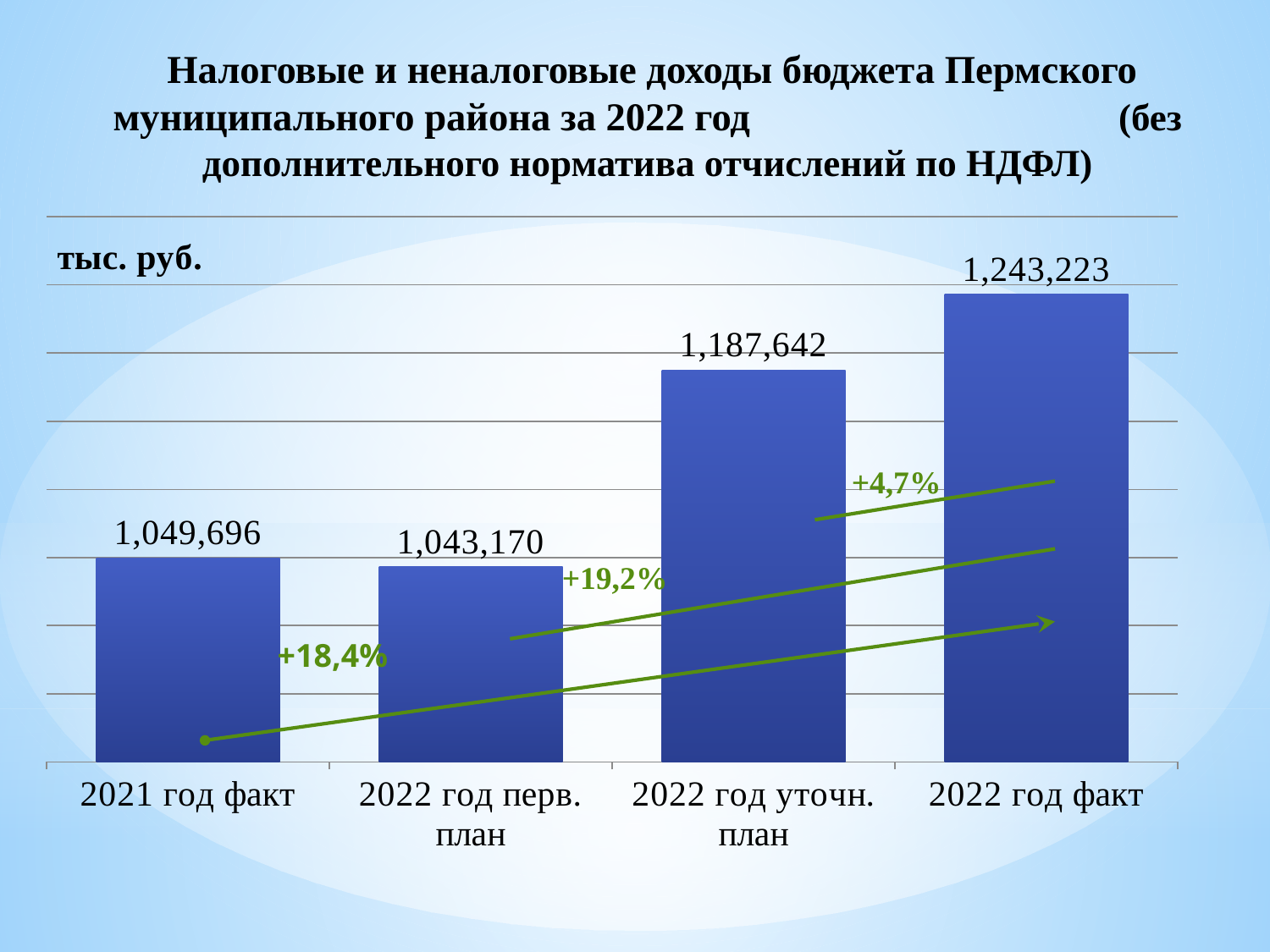
What is the value for 2021 год факт? 1,049,696 What kind of chart is shown on the slide? Bar chart Which category has the highest value? 2022 год факт Which is larger, the value for 2022 год уточн. план or the value for 2022 год перв. план? 2022 год уточн. план What is the difference between the values for 2022 год факт and 2021 год факт? 193,527 What is the value for 2022 год факт? 1,243,223 What is the difference between the values for 2022 год факт and 2022 год уточн. план? 55,581 What is the value for 2022 год перв. план? 1,043,170 What unit of measurement is indicated on the chart? тыс. руб. Which category has the lowest value? 2022 год перв. план How many categories are shown in the chart? 4 What is the value for 2022 год уточн. план? 1,187,642